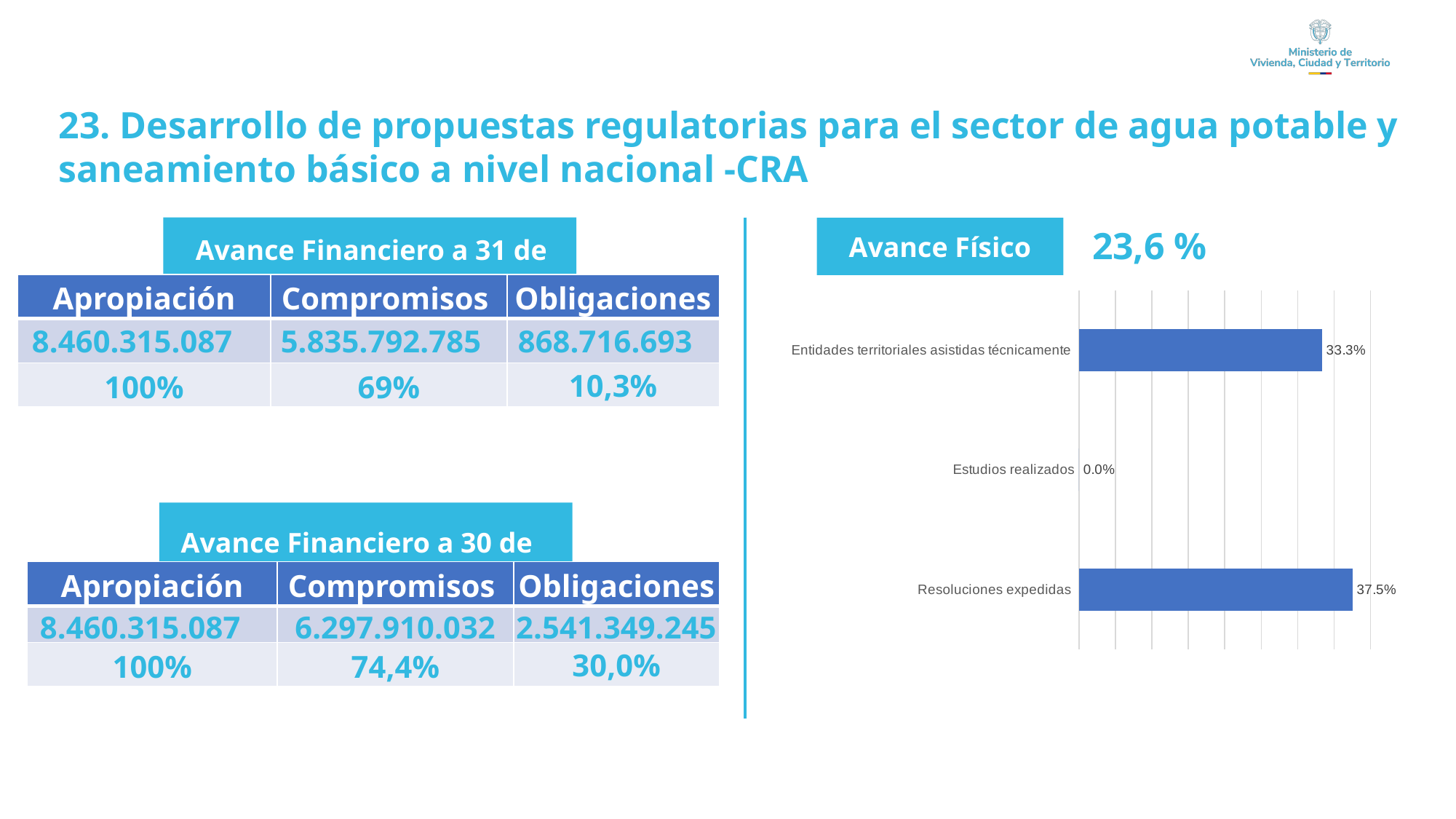
What is the value for Entidades territoriales asistidas técnicamente in the bar chart? 33.3% In the bar chart, which is larger: the value for Entidades territoriales asistidas técnicamente or the value for Resoluciones expedidas? Resoluciones expedidas What is the difference between the values for Resoluciones expedidas and Estudios realizados in the bar chart? 37.5% What is the Avance Físico percentage shown next to the bar chart heading? 23,6 % How many categories are shown in the bar chart? 3 What kind of chart is shown on the right side of the slide? Bar chart Which category has the highest value in the bar chart? Resoluciones expedidas What colour are the bars in the bar chart? Blue What is the value for Resoluciones expedidas in the bar chart? 37.5% What is the difference between the values for Resoluciones expedidas and Entidades territoriales asistidas técnicamente in the bar chart? 4.2% Which category has the lowest value in the bar chart? Estudios realizados What is the value for Estudios realizados in the bar chart? 0.0%